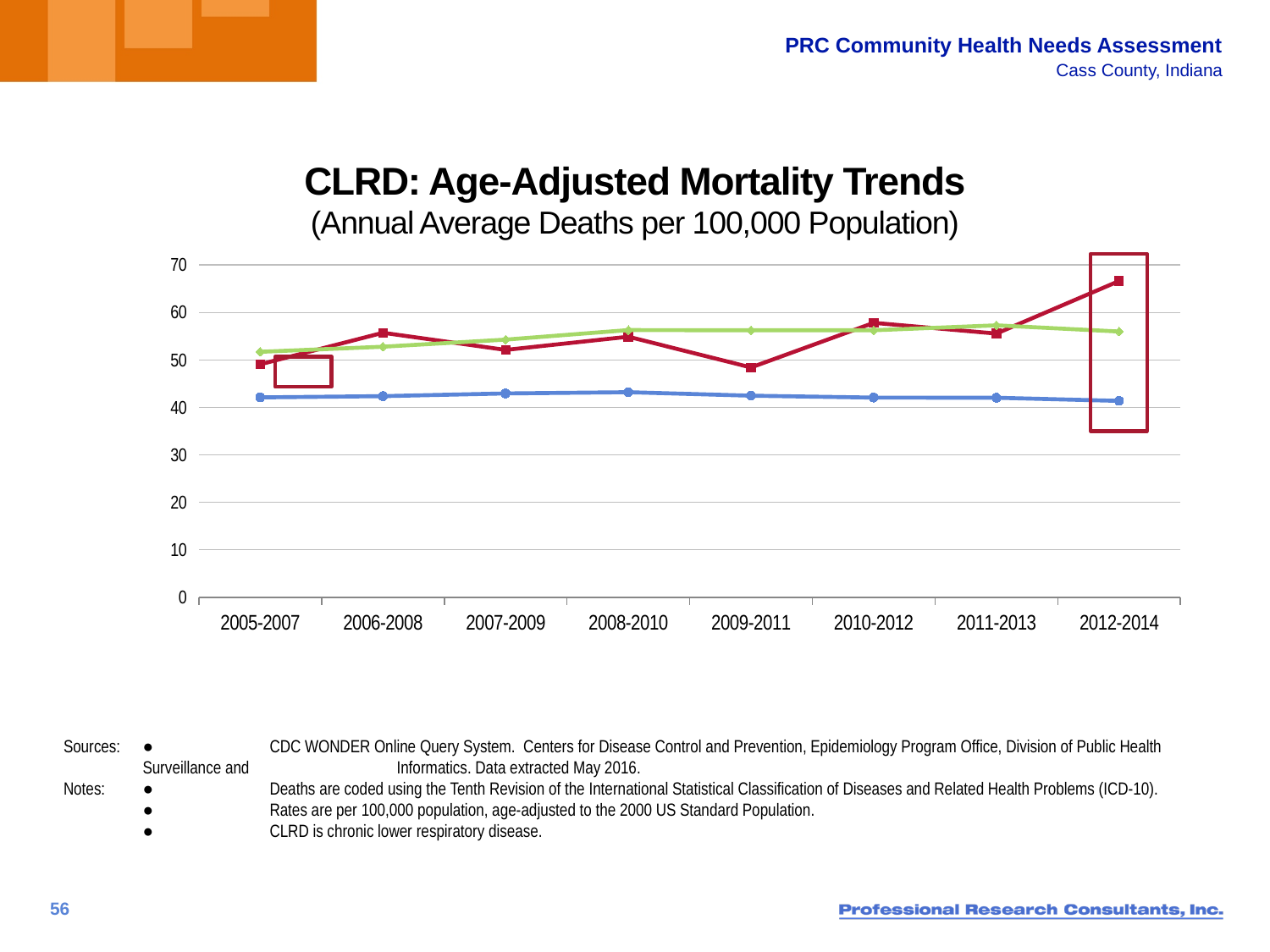
Is the value of the blue line for 2005-2007 greater or less than 40? greater How many data series (lines) are plotted on the chart? 3 Does the red line end higher or lower in 2012-2014 than it started in 2005-2007? higher What is the title of the chart? CLRD: Age-Adjusted Mortality Trends Is the value of the red line for 2012-2014 greater or less than 60? greater How many time periods are shown on the x axis of the chart? 8 For 2009-2011, which line has the higher value, the green line or the red line? green line For 2012-2014, which line has the higher value, the red line or the green line? red line Is the value of the green line for 2008-2010 greater or less than 50? greater In which period does the red line reach its highest value? 2012-2014 What kind of chart is shown on the slide? line chart